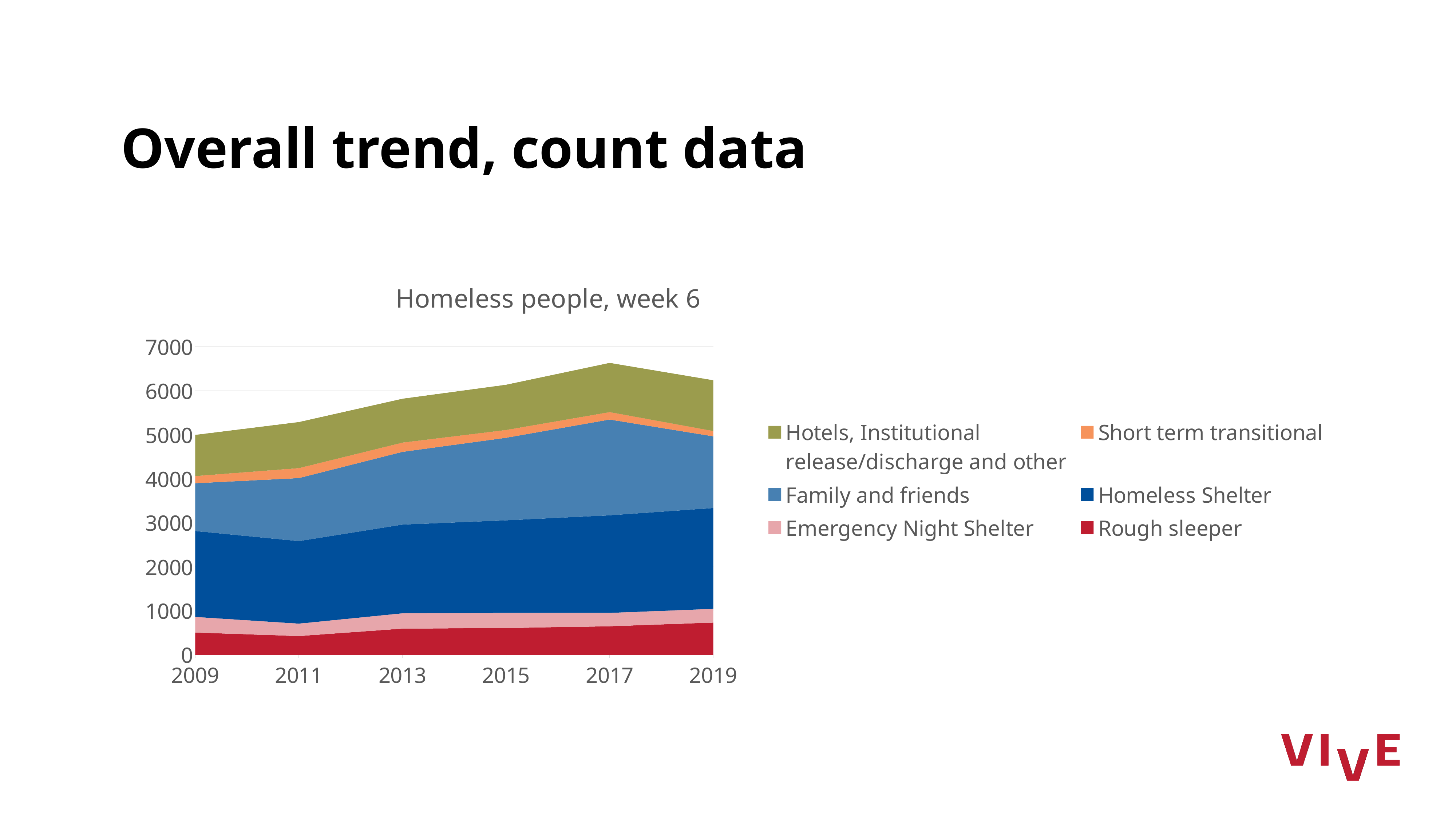
What is the title of the chart? Homeless people, week 6 Which series is larger in 2019, Homeless Shelter or Rough sleeper? Homeless Shelter Does the total number of homeless people rise or fall between 2009 and 2017? Rise How many years are plotted along the x axis? 6 Which series is shown in dark red at the bottom of the stack? Rough sleeper In which year is the total number of homeless people lowest? 2009 Is the total for 2013 greater or less than 6000? less Is the total for 2011 greater or less than 5000? greater How many series does the legend list? 6 What kind of chart is shown on the slide? Stacked area chart In which year is the total number of homeless people highest? 2017 Is the total for 2017 greater or less than 6000? greater